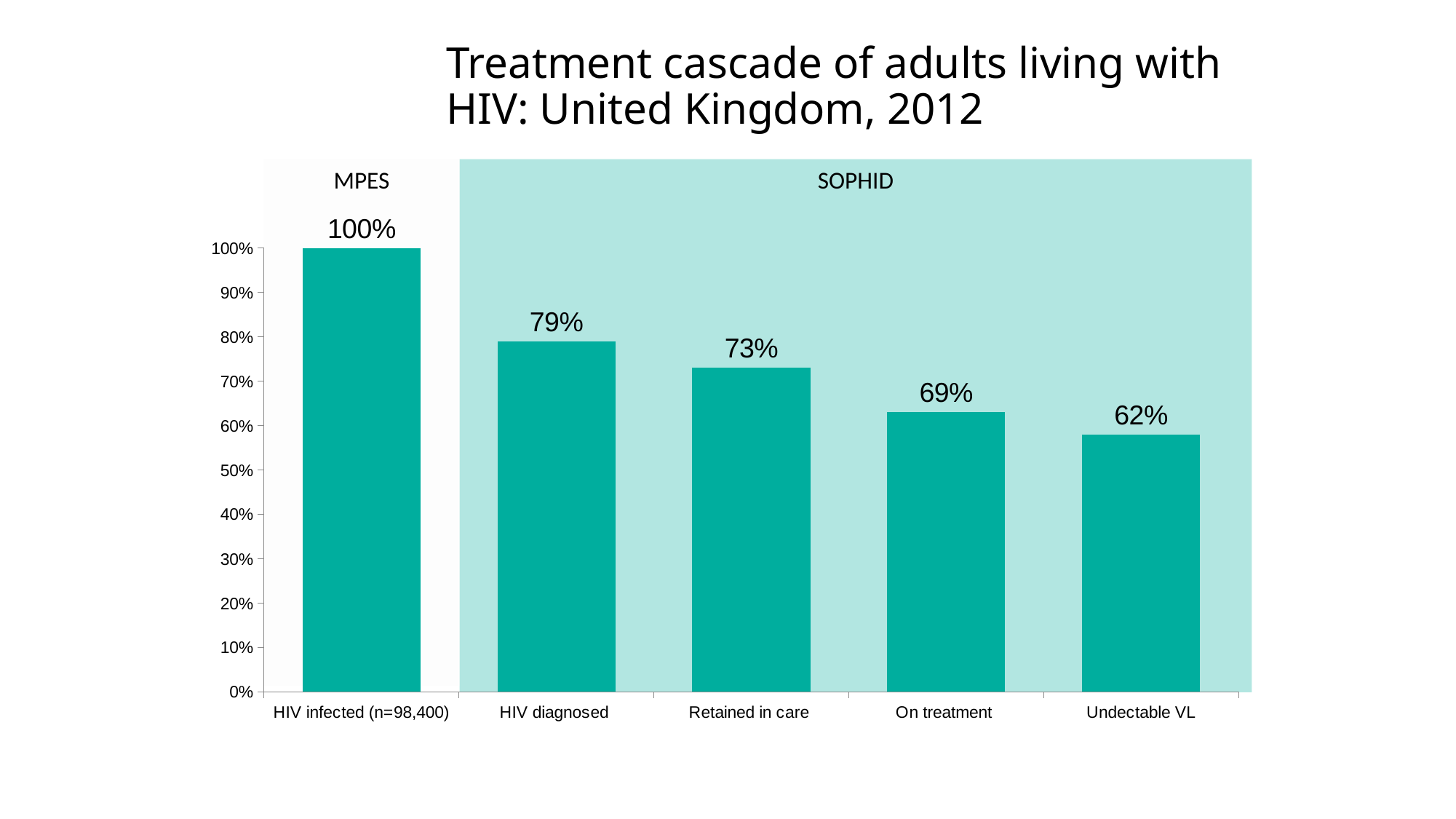
What is the value for Retained in care? 73% What is the value for Undectable VL? 62% What is the title of the chart? Treatment cascade of adults living with HIV: United Kingdom, 2012 What is the value for On treatment? 69% What is the difference between the values for HIV diagnosed and Undectable VL? 17% What is the value for HIV diagnosed? 79% Which category has the lowest value? Undectable VL What kind of chart is this? Bar chart Which is larger, the value for Retained in care or the value for On treatment? Retained in care Do the values rise or fall from left to right along the x axis? Fall Which category has the highest value? HIV infected (n=98,400) How many categories are shown on the x axis? 5